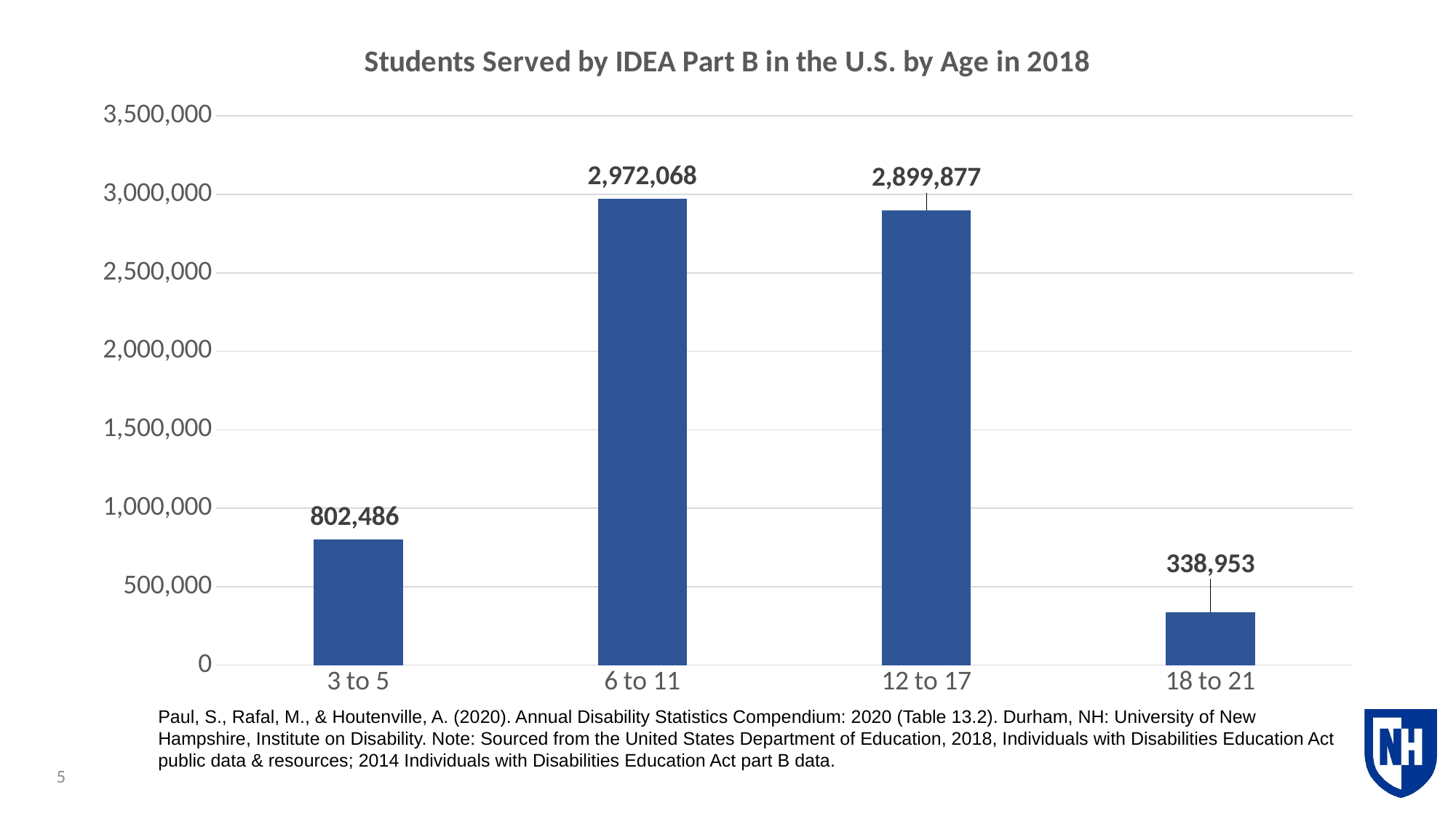
How many age groups are shown on the chart? 4 Which age group has the highest number of students served? 6 to 11 What is the value shown for the 6 to 11 age group? 2,972,068 What is the difference between the values for the 6 to 11 and 12 to 17 age groups? 72,191 What kind of chart is shown on the slide? Bar chart Which age group has a larger value, 3 to 5 or 18 to 21? 3 to 5 Is the value for the 12 to 17 age group greater or less than 3,000,000? less How many students aged 3 to 5 were served by IDEA Part B in 2018? 802,486 What is the difference between the values for the 3 to 5 and 18 to 21 age groups? 463,533 What is the title of the chart? Students Served by IDEA Part B in the U.S. by Age in 2018 What is the value shown for the 18 to 21 age group? 338,953 Which age group has the lowest number of students served? 18 to 21